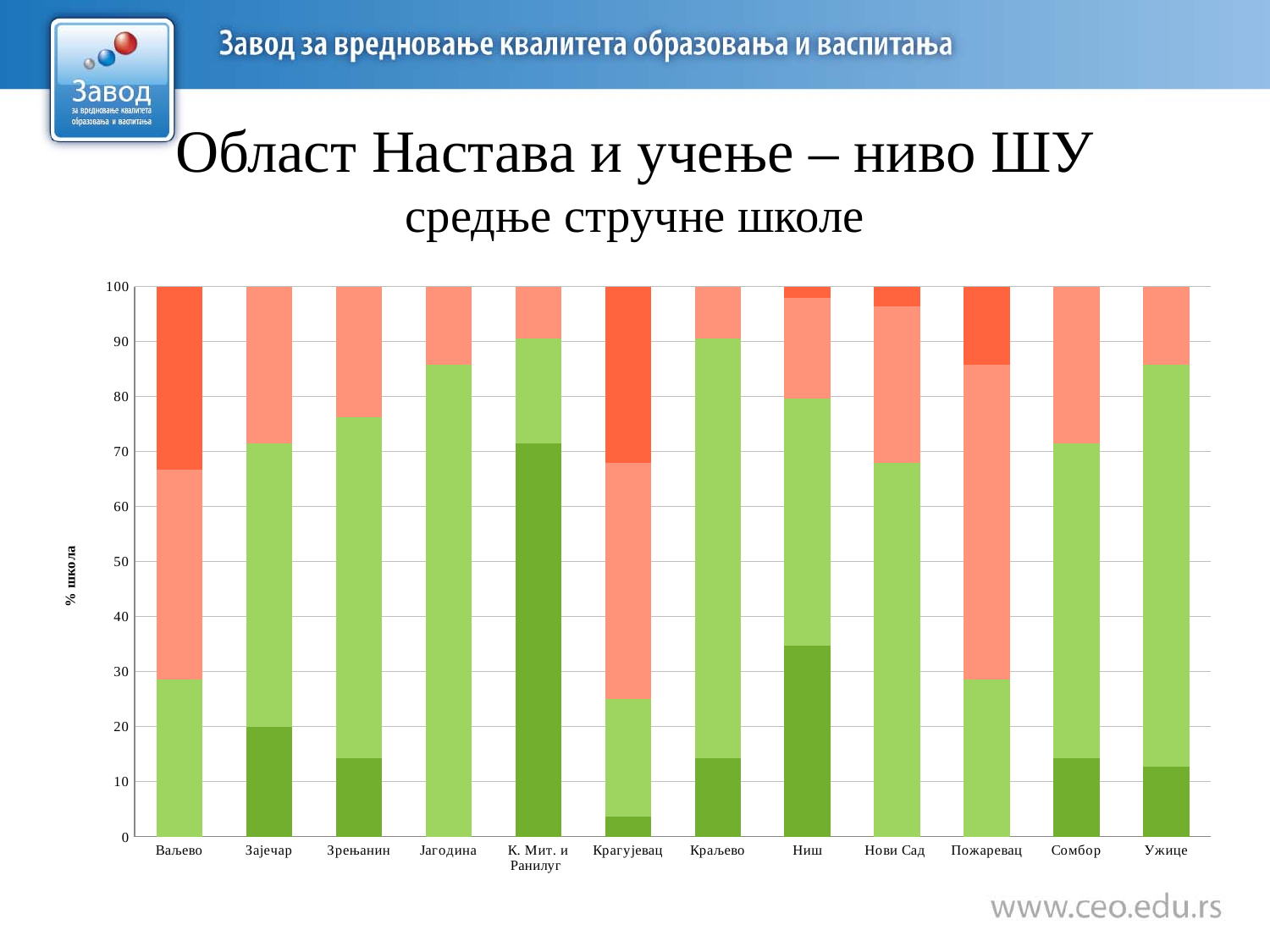
Which category has the largest dark green (bottom) segment? К. Мит. и Ранилуг Is the dark green (bottom) segment for К. Мит. и Ранилуг greater or less than 60? greater Which has the larger dark green (bottom) segment, Зајечар or Зрењанин? Зајечар What is the label of the y axis of the chart? % школа Is the top of the light green segment for Ужице greater or less than 80? greater What kind of chart is shown on the slide? Stacked bar chart Which has the larger dark red (top) segment, Ваљево or Пожаревац? Ваљево How many categories (cities) are shown on the x axis of the chart? 12 Is the dark green (bottom) segment for Ниш greater or less than 30? greater What is the total height of the stacked bar for Зајечар? 100